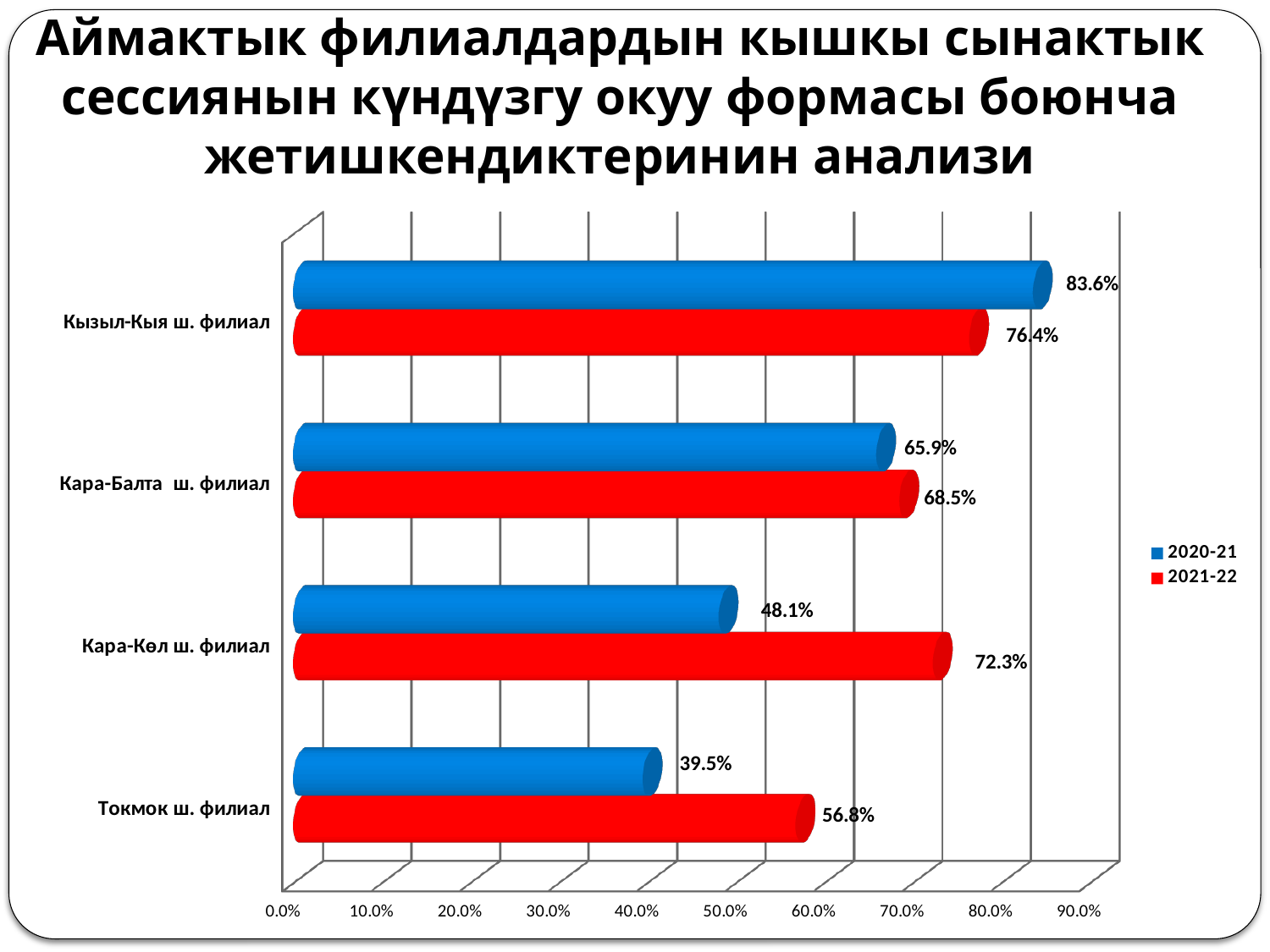
Which branch has the lowest 2021-22 value? Токмок ш. филиал What type of chart is shown on the slide? Bar chart What is the 2020-21 value for Кара-Балта ш. филиал? 65.9% What is the 2020-21 value for Кызыл-Кыя ш. филиал? 83.6% What is the difference between the 2021-22 and 2020-21 values for Кара-Көл ш. филиал? 24.2% For Кызыл-Кыя ш. филиал, which is larger: the 2020-21 value or the 2021-22 value? 2020-21 What is the 2021-22 value for Кара-Көл ш. филиал? 72.3% Which branch has the highest 2020-21 value? Кызыл-Кыя ш. филиал How many series does the legend list? 2 What is the 2021-22 value for Токмок ш. филиал? 56.8% How many branches are shown on the chart? 4 Which colour represents the 2021-22 series? Red